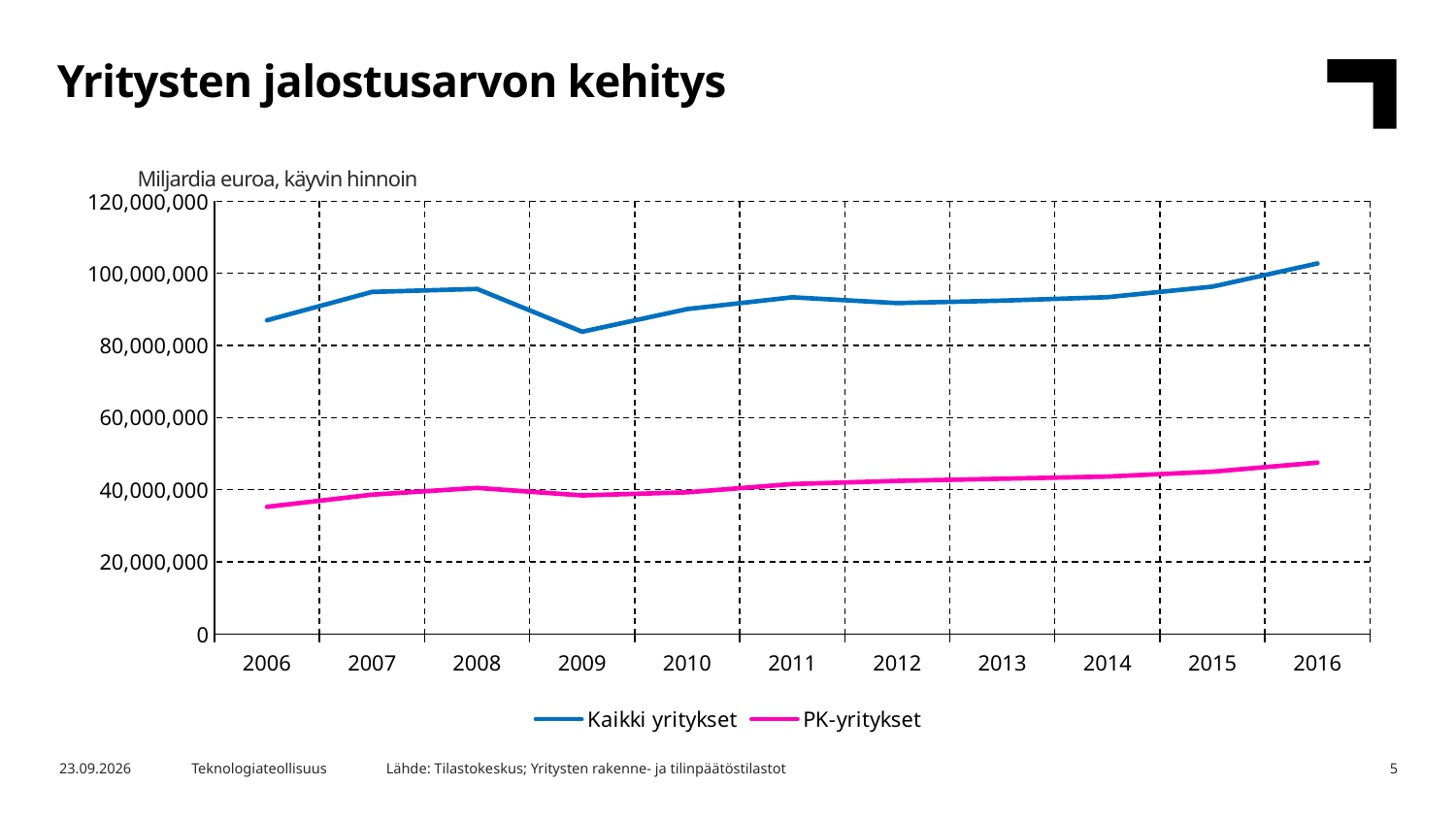
Is the value for PK-yritykset in 2006 greater or less than 40,000,000? less What kind of chart is shown on the slide? Line chart Does the value for PK-yritykset rise or fall from 2006 to 2016? Rise Is the value for Kaikki yritykset in 2007 greater or less than 100,000,000? less Is the value for Kaikki yritykset in 2016 greater or less than 100,000,000? greater What is the title of the chart? Yritysten jalostusarvon kehitys Which series has the larger value in 2010, Kaikki yritykset or PK-yritykset? Kaikki yritykset How many years are shown on the x axis? 11 How many series does the legend list? 2 In which year is the value for PK-yritykset lowest? 2006 In which year is the value for Kaikki yritykset highest? 2016 In which year is the value for Kaikki yritykset lowest? 2009